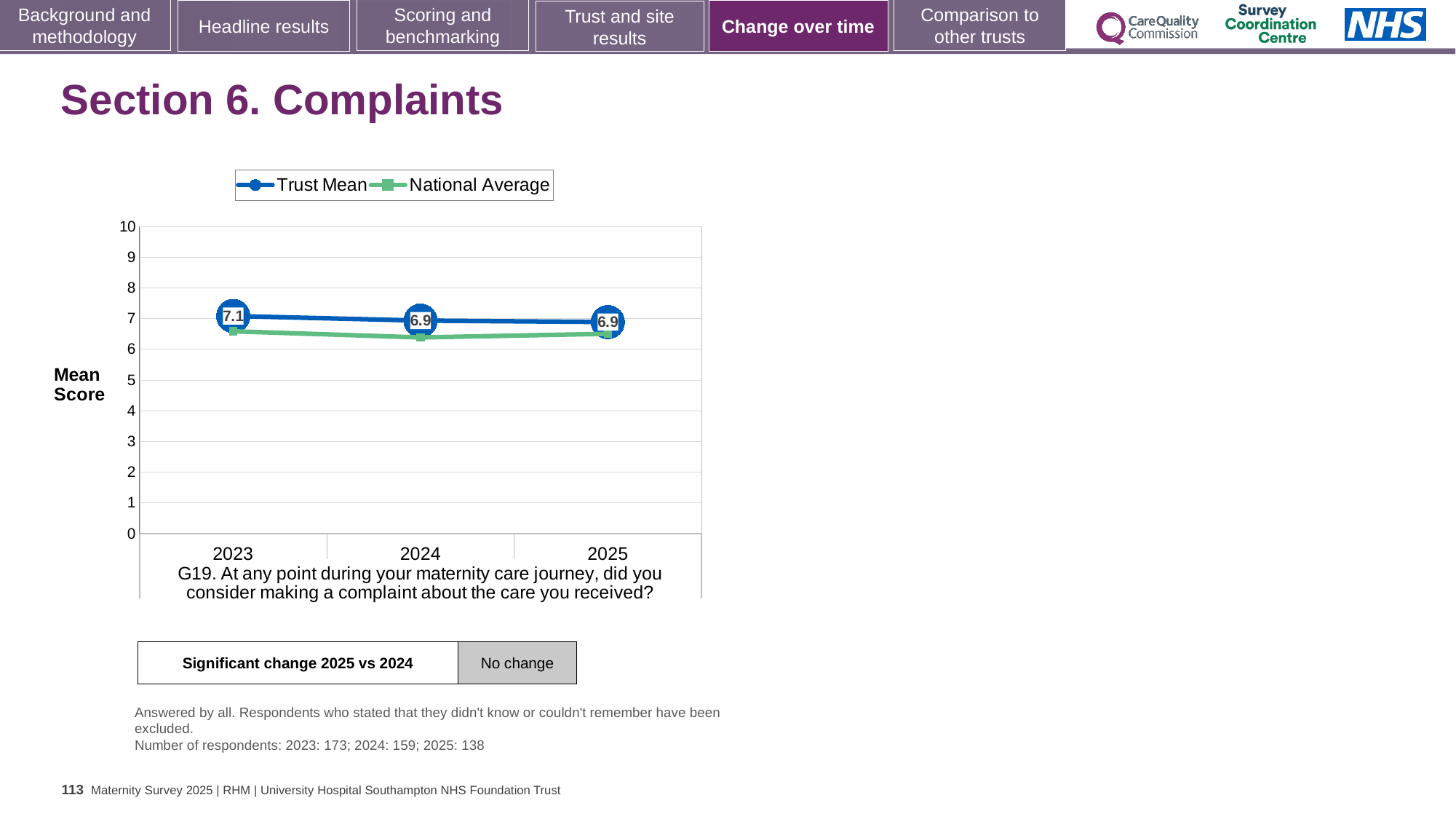
What is the Trust Mean score for 2025? 6.9 What is the difference between the Trust Mean score in 2023 and in 2024? 0.2 Is the National Average value for 2024 greater or less than 7? less What kind of chart is shown on the slide? Line chart What is the Trust Mean score for 2024? 6.9 Does the Trust Mean rise or fall from 2023 to 2025? Fall Is the National Average value for 2025 greater or less than 6? greater What is the Trust Mean score for 2023? 7.1 How many series does the legend list? 2 How many years are plotted on the x axis? 3 In 2023, which is higher: the Trust Mean or the National Average? Trust Mean In which year is the Trust Mean score highest? 2023